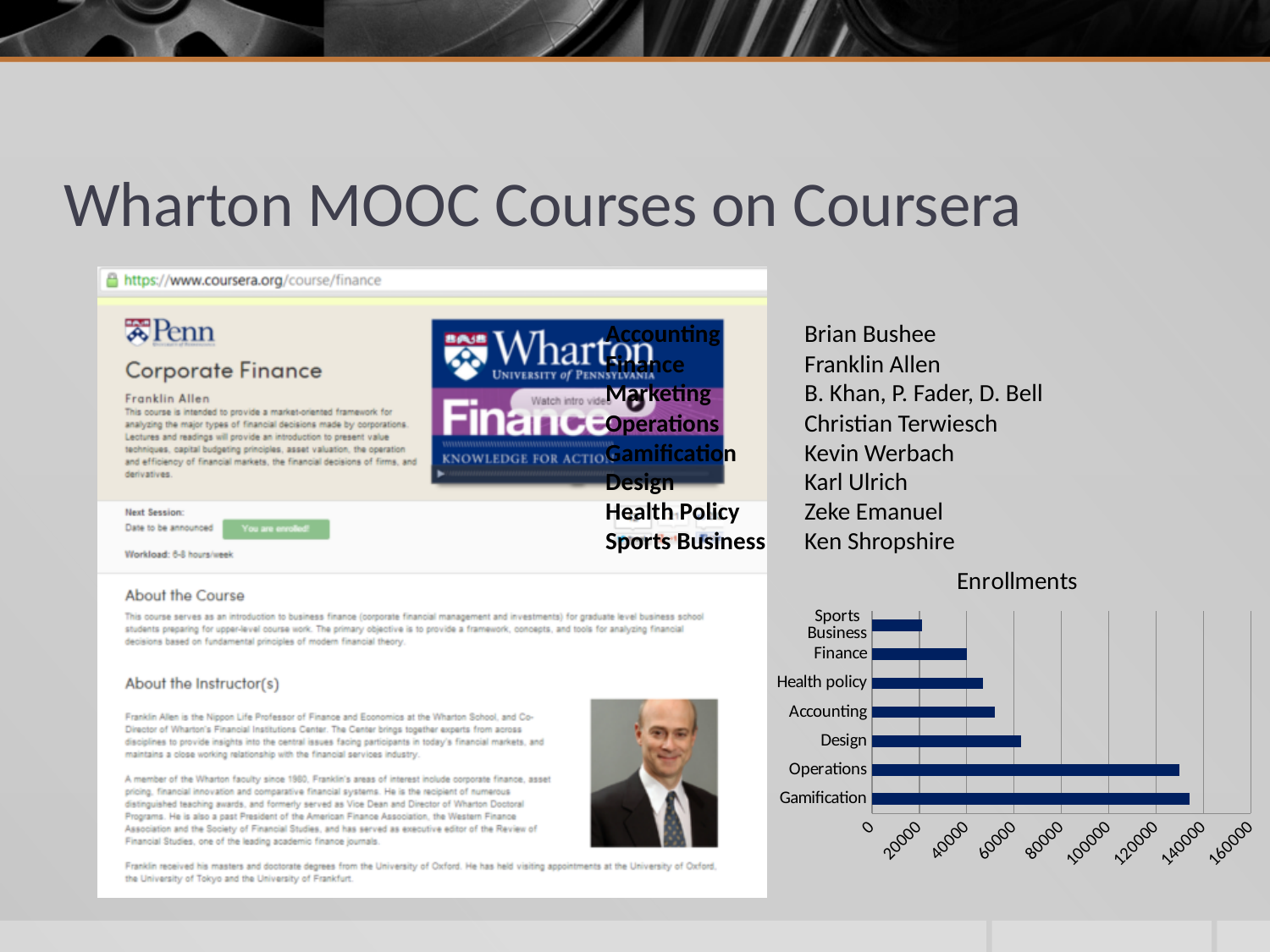
Which has a higher enrollment, Accounting or Sports Business? Accounting Which category has the lowest enrollment in the chart? Sports Business What is the title of the chart? Enrollments Which has a higher enrollment, Operations or Design? Operations What type of chart is shown on the slide? bar chart Is the enrollment value for Health policy greater or less than 60000? less Is the enrollment value for Sports Business greater or less than 40000? less Is the enrollment value for Gamification greater or less than 120000? greater How many categories are plotted in the Enrollments chart? 7 What colour are the bars in the Enrollments chart? dark blue